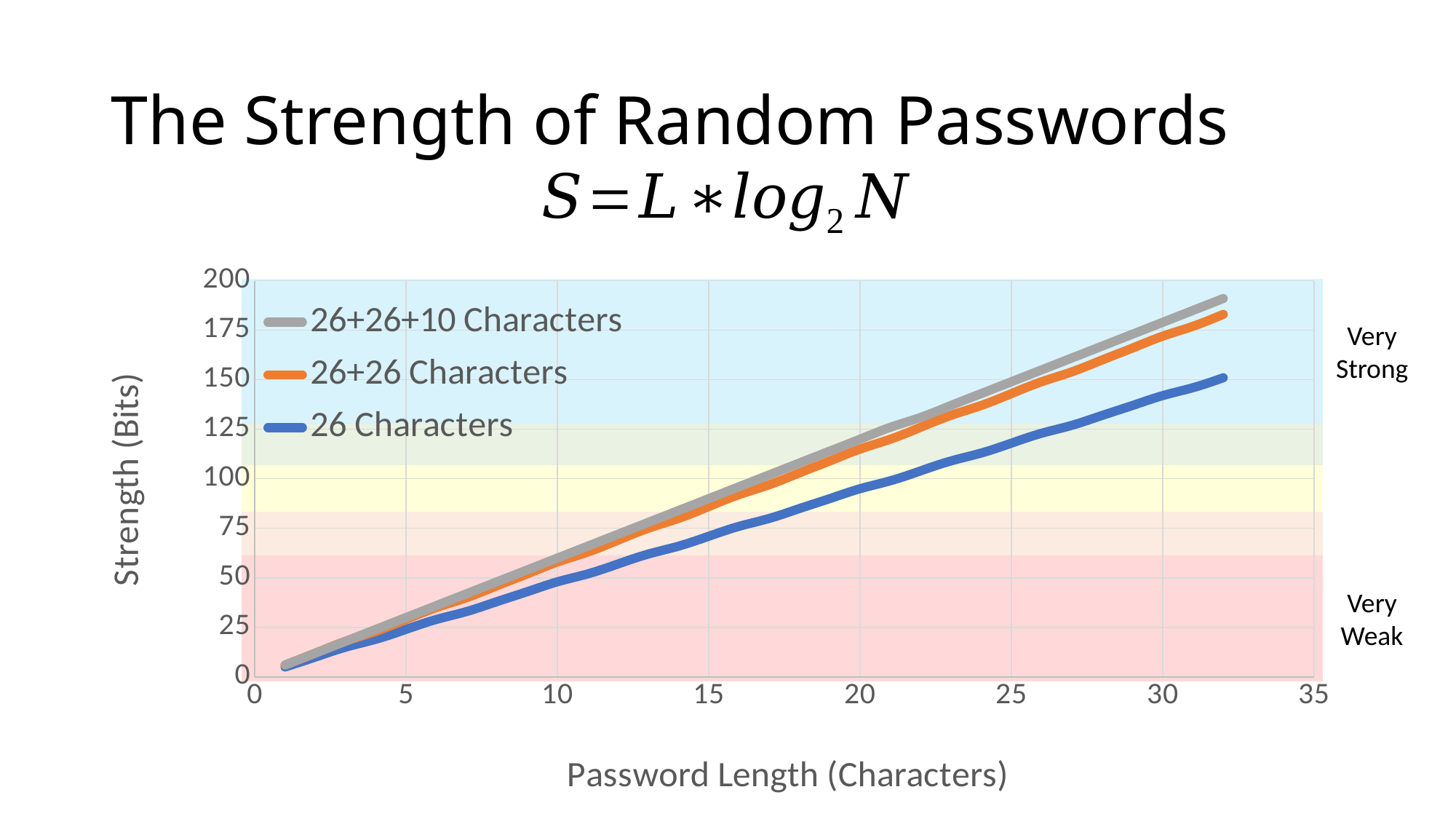
At a password length of 30, is the value for 26 Characters greater or less than 150? less Does the strength of the 26 Characters series rise or fall as password length increases? rise At a password length of 25, which series has the higher strength, 26+26+10 Characters or 26 Characters? 26+26+10 Characters What is the label of the horizontal axis? Password Length (Characters) Which series has the lowest strength at the right end of the chart? 26 Characters What kind of chart is shown on the slide? line chart At a password length of 20, is the value for 26 Characters greater or less than 100? less Which series reaches the highest strength at the right end of the chart? 26+26+10 Characters What is the label of the vertical axis? Strength (Bits) At a password length of 30, is the value for 26+26 Characters greater or less than 150? greater How many series does the legend list? 3